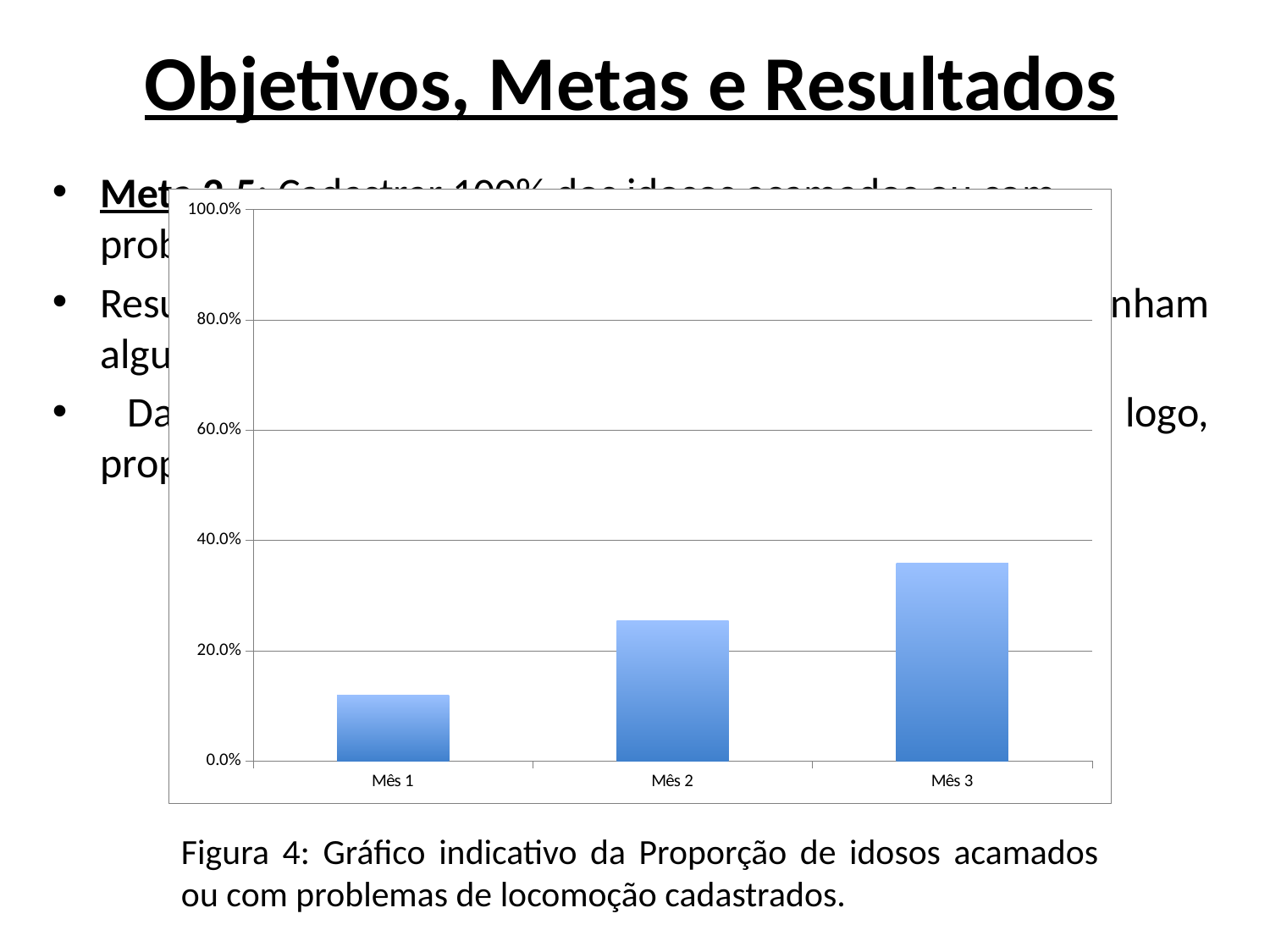
How many categories (months) are plotted on the x axis of the chart? 3 Is the value for Mês 3 greater or less than 20.0%? greater Which month has the lowest bar in the chart? Mês 1 Do the values rise or fall from Mês 1 to Mês 3? rise Which is larger, the value for Mês 2 or the value for Mês 3? Mês 3 Is the value for Mês 1 greater or less than 20.0%? less Is the value for Mês 3 greater or less than 40.0%? less What is the maximum value shown on the chart's vertical axis? 100.0% Which month has the highest bar in the chart? Mês 3 Which is larger, the value for Mês 2 or the value for Mês 1? Mês 2 What kind of chart is shown on the slide? bar chart